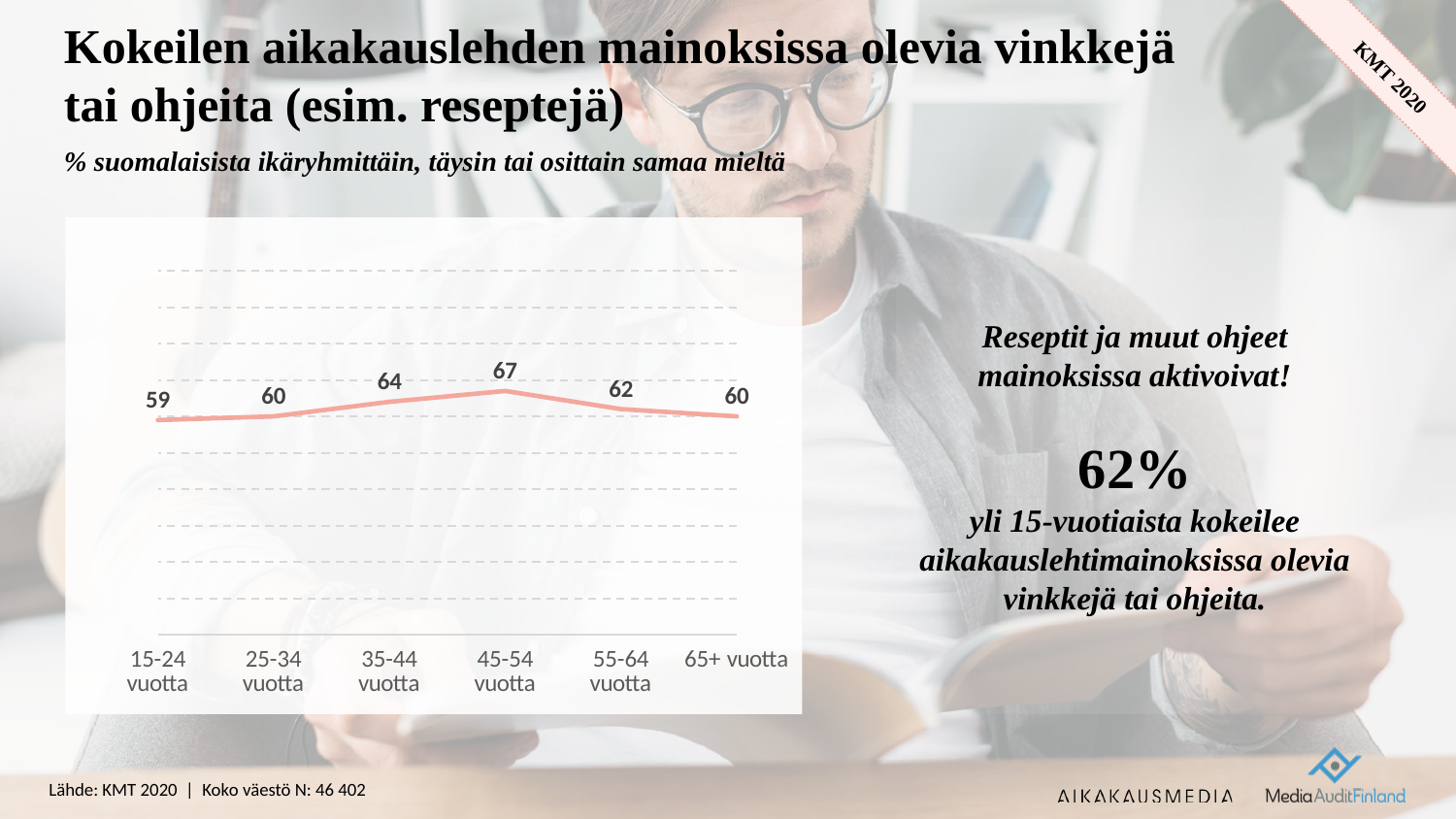
Which age group has the highest value? 45-54 vuotta Which age group has the lowest value? 15-24 vuotta What is the difference between the values for 45-54 vuotta and 15-24 vuotta? 8 What is the value for the 15-24 vuotta age group? 59 Which is larger, the value for 35-44 vuotta or the value for 55-64 vuotta? 35-44 vuotta What is the value for the 65+ vuotta age group? 60 What is the value for the 55-64 vuotta age group? 62 Do the values rise or fall from 15-24 vuotta to 45-54 vuotta? Rise What is the title of the chart on the slide? Kokeilen aikakauslehden mainoksissa olevia vinkkejä tai ohjeita (esim. reseptejä) How many age groups are shown on the x axis? 6 What is the value for the 45-54 vuotta age group? 67 What kind of chart is shown on the slide? Line chart